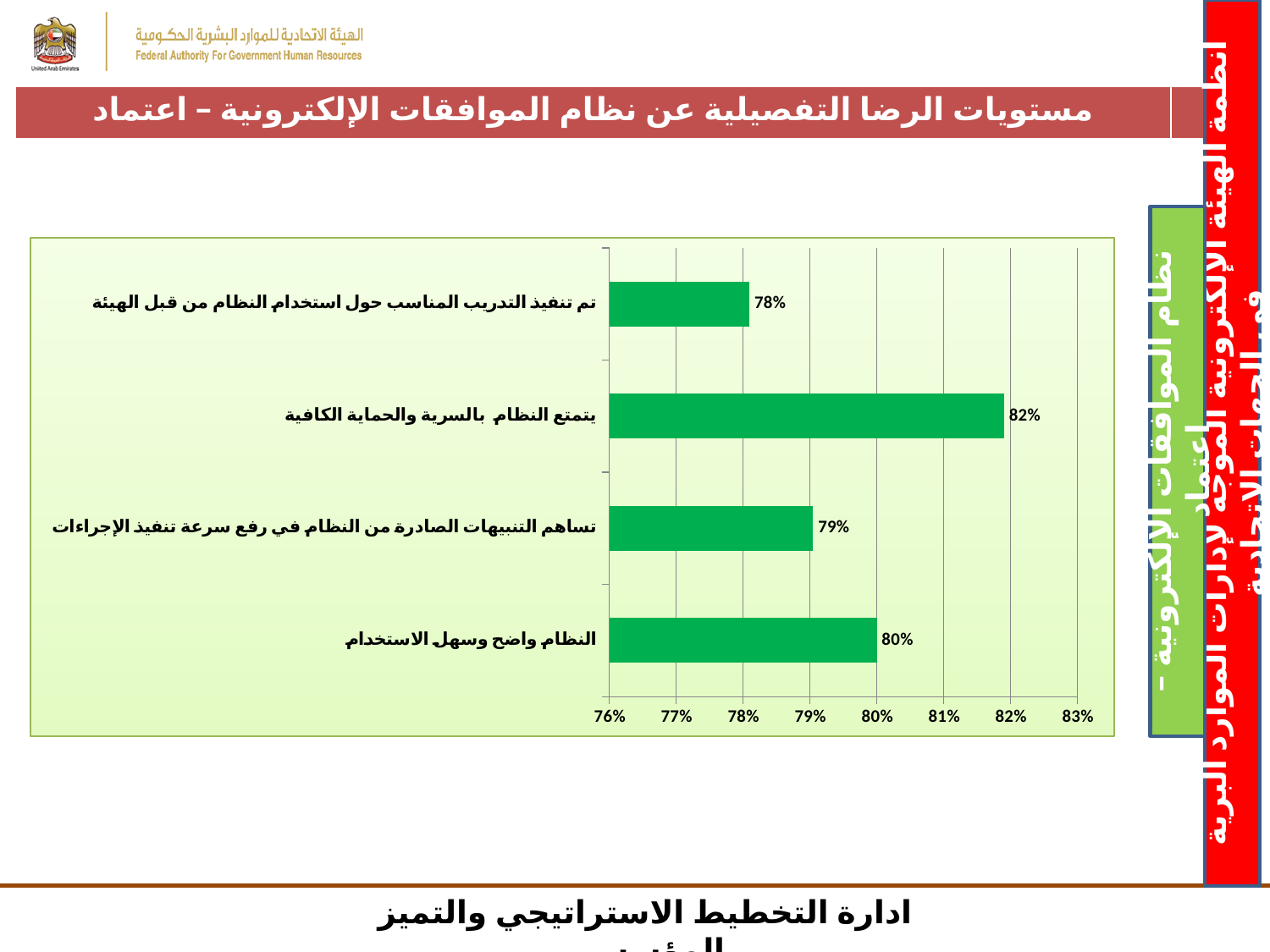
What kind of chart is shown on the slide? bar chart Which category has the highest value? يتمتع النظام بالسرية والحماية الكافية What is the value for "يتمتع النظام بالسرية والحماية الكافية"? 82% Which is larger: the value for "النظام واضح وسهل الاستخدام" or the value for "تساهم التنبيهات الصادرة من النظام في رفع سرعة تنفيذ الإجراءات"? النظام واضح وسهل الاستخدام How many categories are shown in the chart? 4 What is the difference between the values for "يتمتع النظام بالسرية والحماية الكافية" and "تم تنفيذ التدريب المناسب حول استخدام النظام من قبل الهيئة"? 4% What is the value for "تساهم التنبيهات الصادرة من النظام في رفع سرعة تنفيذ الإجراءات"? 79% What is the value for "تم تنفيذ التدريب المناسب حول استخدام النظام من قبل الهيئة"? 78% Is the value for "يتمتع النظام بالسرية والحماية الكافية" greater or less than 80%? greater Which category has the lowest value? تم تنفيذ التدريب المناسب حول استخدام النظام من قبل الهيئة What is the title of the slide containing the chart? مستويات الرضا التفصيلية عن نظام الموافقات الإلكترونية – اعتماد What is the value for "النظام واضح وسهل الاستخدام"? 80%